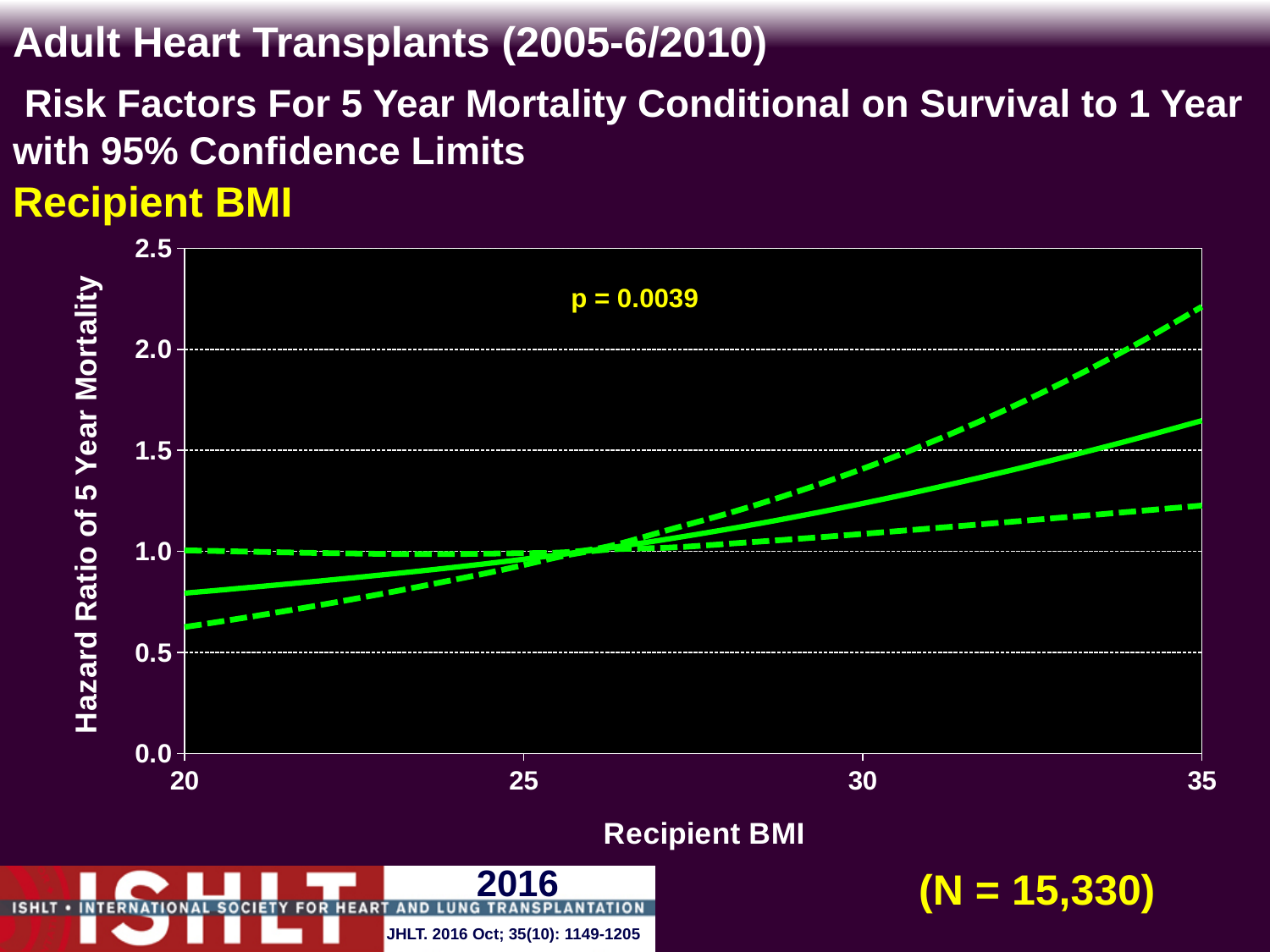
What is the sample size (N) shown on the slide? N = 15,330 Is the upper 95% confidence limit (upper dashed line) at a Recipient BMI of 35 greater or less than 2.0? greater Is the hazard ratio (solid line) at a Recipient BMI of 35 greater or less than 1.5? greater What is the p-value printed on the chart? p = 0.0039 What is the label of the y axis? Hazard Ratio of 5 Year Mortality Is the hazard ratio (solid line) at a Recipient BMI of 20 greater or less than 1.0? less Does the hazard ratio (solid line) rise or fall as Recipient BMI increases from 20 to 35? rise How many lines are plotted on the chart? 3 What kind of chart is shown on the slide? line chart What is the label of the x axis? Recipient BMI